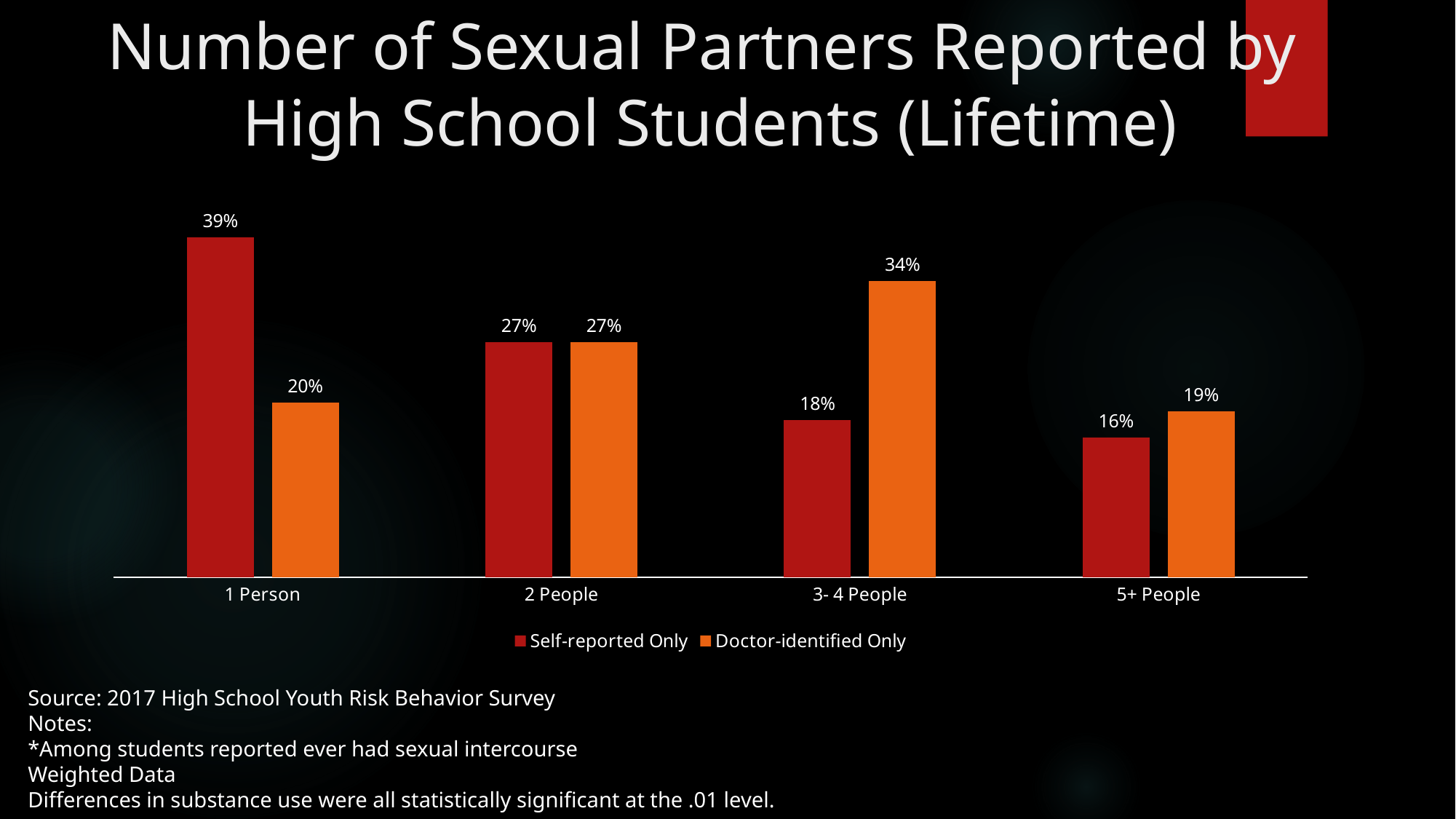
What is the Self-reported Only value for 1 Person? 39% Which category has the lowest Doctor-identified Only value? 5+ People How many categories are shown on the x axis? 4 What is the Doctor-identified Only value for 5+ People? 19% Which category has the highest Self-reported Only value? 1 Person For 3- 4 People, which series has the larger value, Self-reported Only or Doctor-identified Only? Doctor-identified Only What is the Doctor-identified Only value for 3- 4 People? 34% What is the difference between the Self-reported Only and Doctor-identified Only values for 1 Person? 19% What kind of chart is shown on the slide? Bar chart Do the Self-reported Only values rise or fall from 1 Person to 5+ People? Fall What colour are the Doctor-identified Only bars? Orange How many series does the legend list? 2